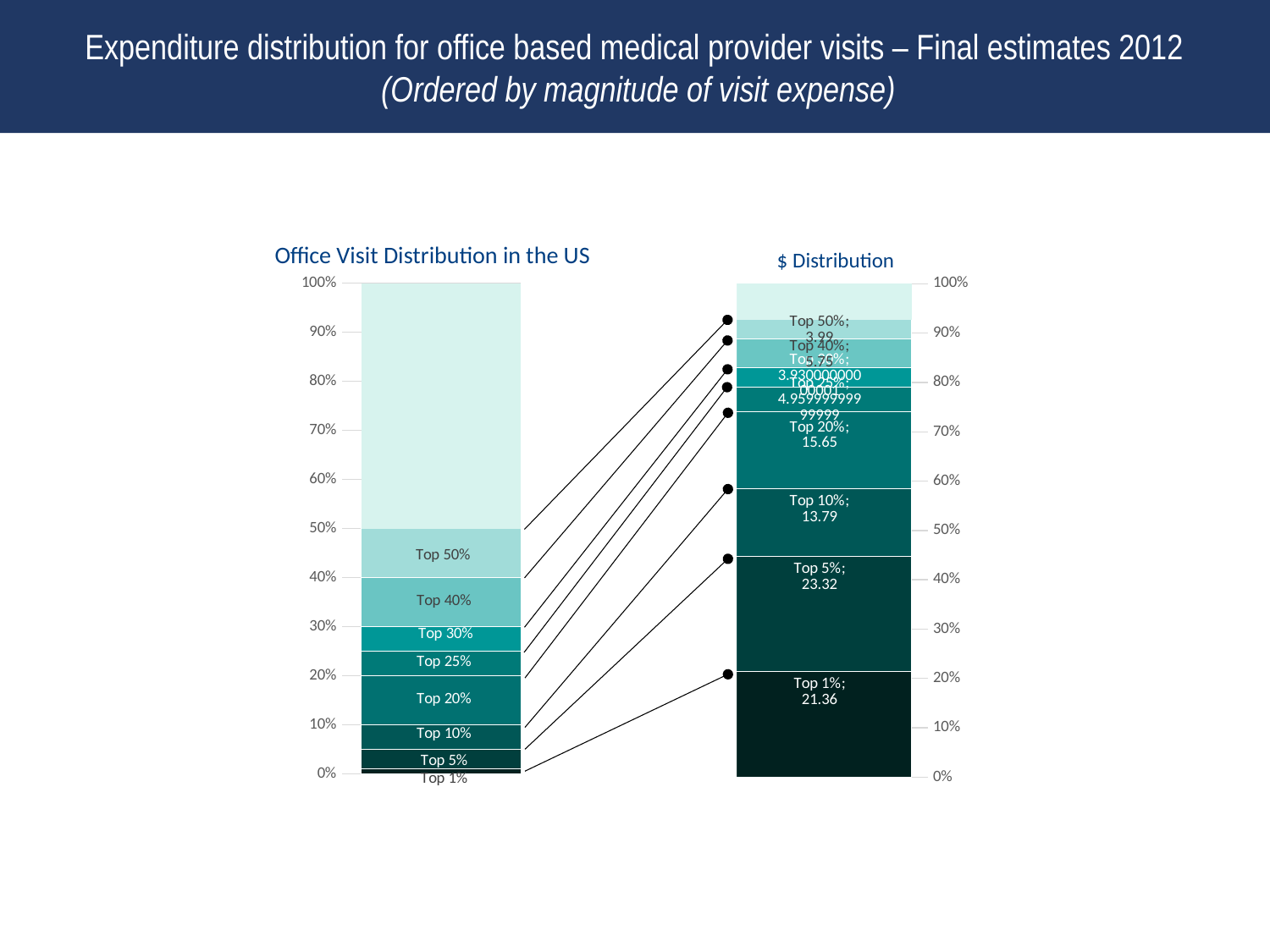
In the $ Distribution chart, what is the value labelled for Top 5%? 23.32 What kind of chart is the Office Visit Distribution in the US chart? Stacked bar chart In the $ Distribution chart, what is the value labelled for Top 40%? 5.75 In the $ Distribution chart, what is the difference between the values for Top 20% and Top 10%? 1.86 In the $ Distribution chart, what is the value labelled for Top 50%? 3.99 In the $ Distribution chart, which is larger, the value for Top 5% or the value for Top 1%? Top 5% In the $ Distribution chart, what is the difference between the values for Top 5% and Top 1%? 1.96 In the $ Distribution chart, what is the value labelled for Top 20%? 15.65 In the $ Distribution chart, what is the value labelled for Top 10%? 13.79 What is the title of the chart on the left of the slide? Office Visit Distribution in the US In the $ Distribution chart, what is the value labelled for Top 1%? 21.36 In the $ Distribution chart, which segment has the largest labelled value? Top 5%